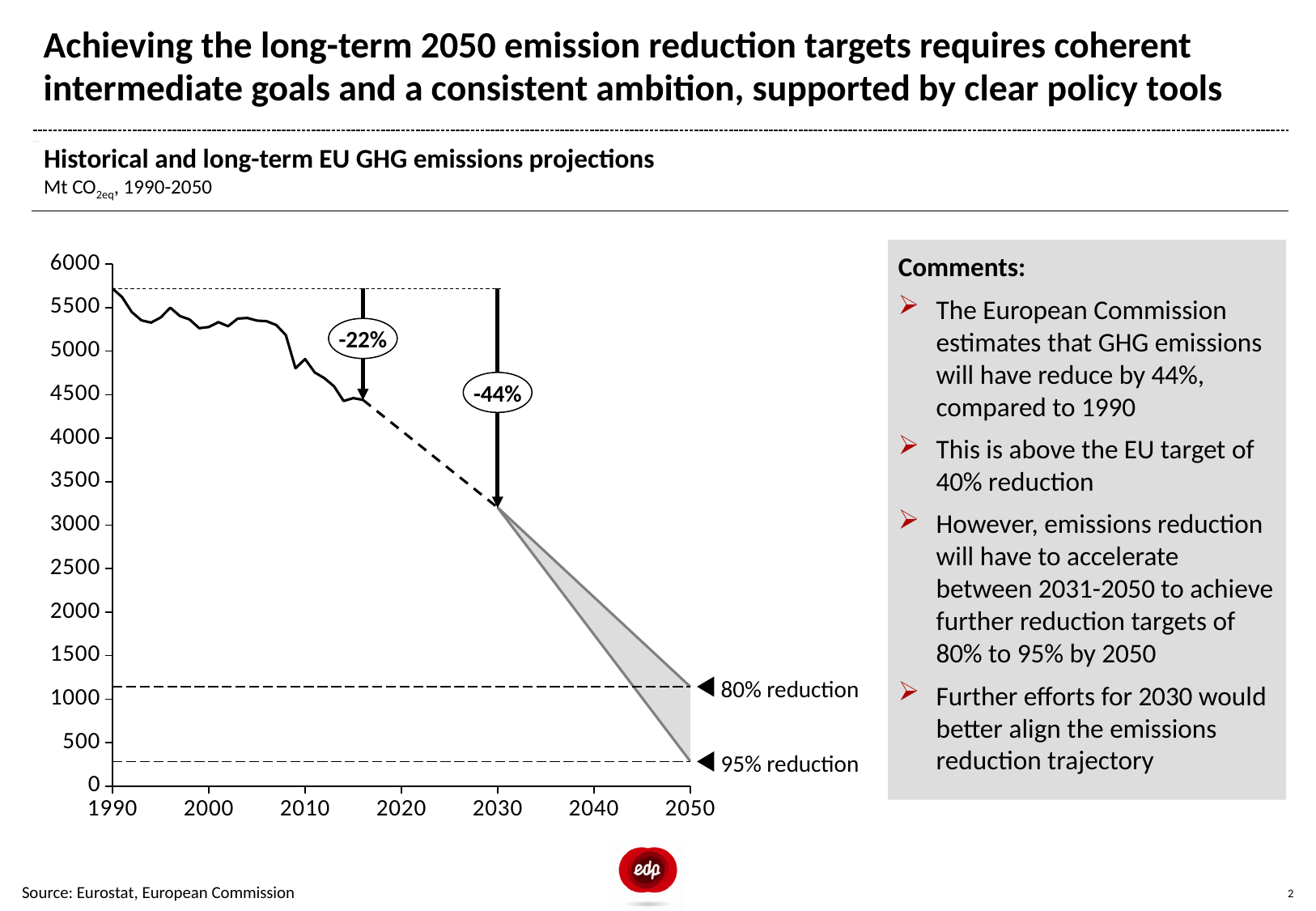
Which year has the larger emissions value, 2010 or 2020? 2010 What unit is given for the chart's values? Mt CO2eq Do the emissions values rise or fall from 1990 to 2050 along the x axis? fall Which year has the larger emissions value, 1990 or 2030? 1990 What kind of chart is shown on the slide? line chart Is the 2050 value on the 80% reduction path greater or less than 1500? less What percentage reduction is annotated at the 2030 point of the chart? -44% What is the title of the chart? Historical and long-term EU GHG emissions projections Is the emissions value for 2030 greater or less than 3500? less Is the 2050 value on the 95% reduction path greater or less than 500? less What percentage reduction is annotated by the first (left) arrow on the chart? -22%